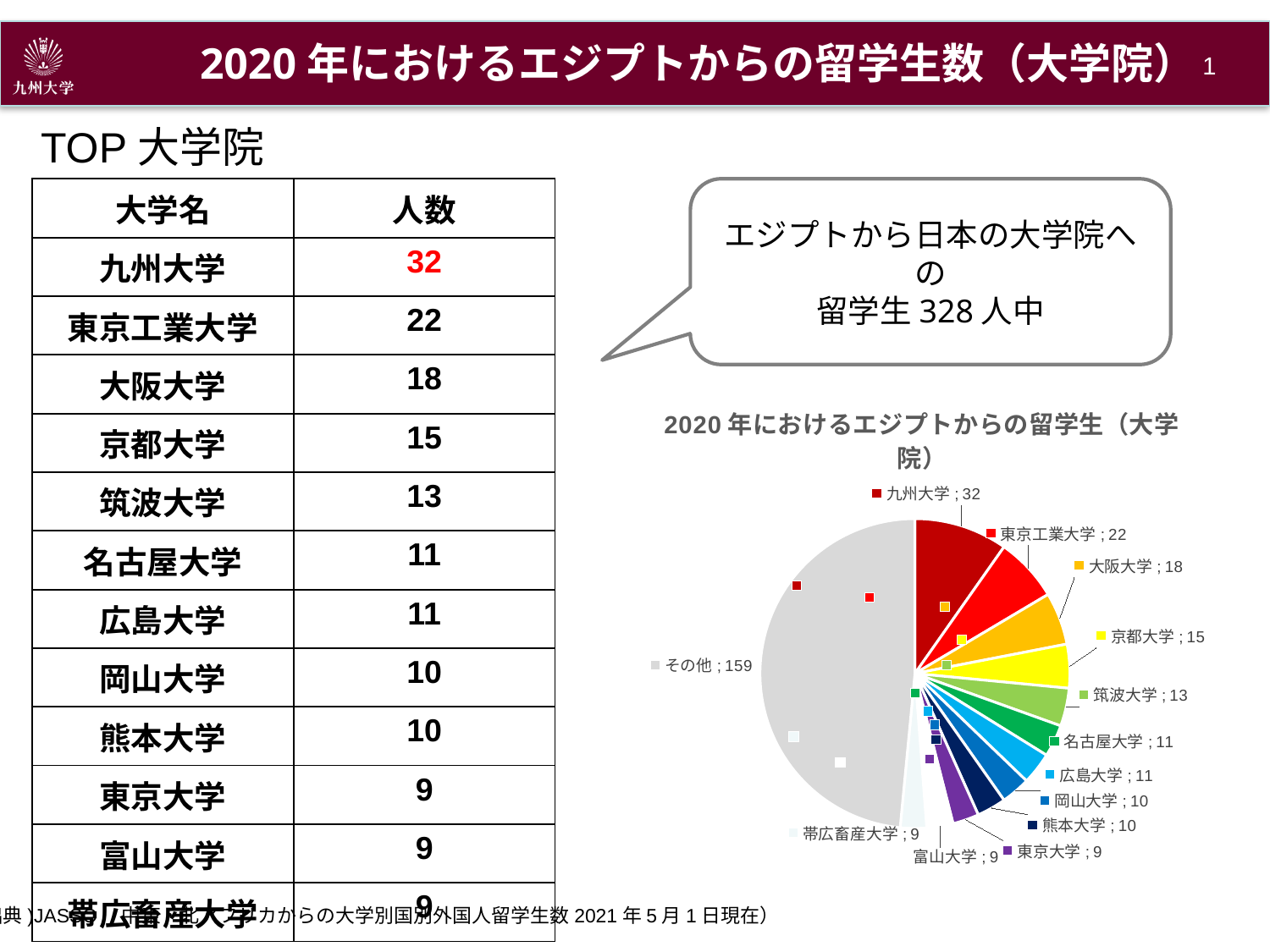
Excluding その他, which university has the largest slice in the pie chart? 九州大学 In the pie chart, what is the difference between the values for 九州大学 and 東京工業大学? 10 What kind of chart is shown on the slide? pie chart In the pie chart, what is the difference between the values for その他 and 九州大学? 127 In the pie chart, what is the value for その他? 159 In the pie chart, what is the value for 熊本大学? 10 In the pie chart, what is the value for 九州大学? 32 What is the title of the pie chart? 2020年におけるエジプトからの留学生（大学院） In the pie chart, which is larger, the value for 大阪大学 or the value for 京都大学? 大阪大学 Which slice of the pie chart is the largest? その他 In the pie chart, what is the value for 筑波大学? 13 How many slices does the pie chart have? 13